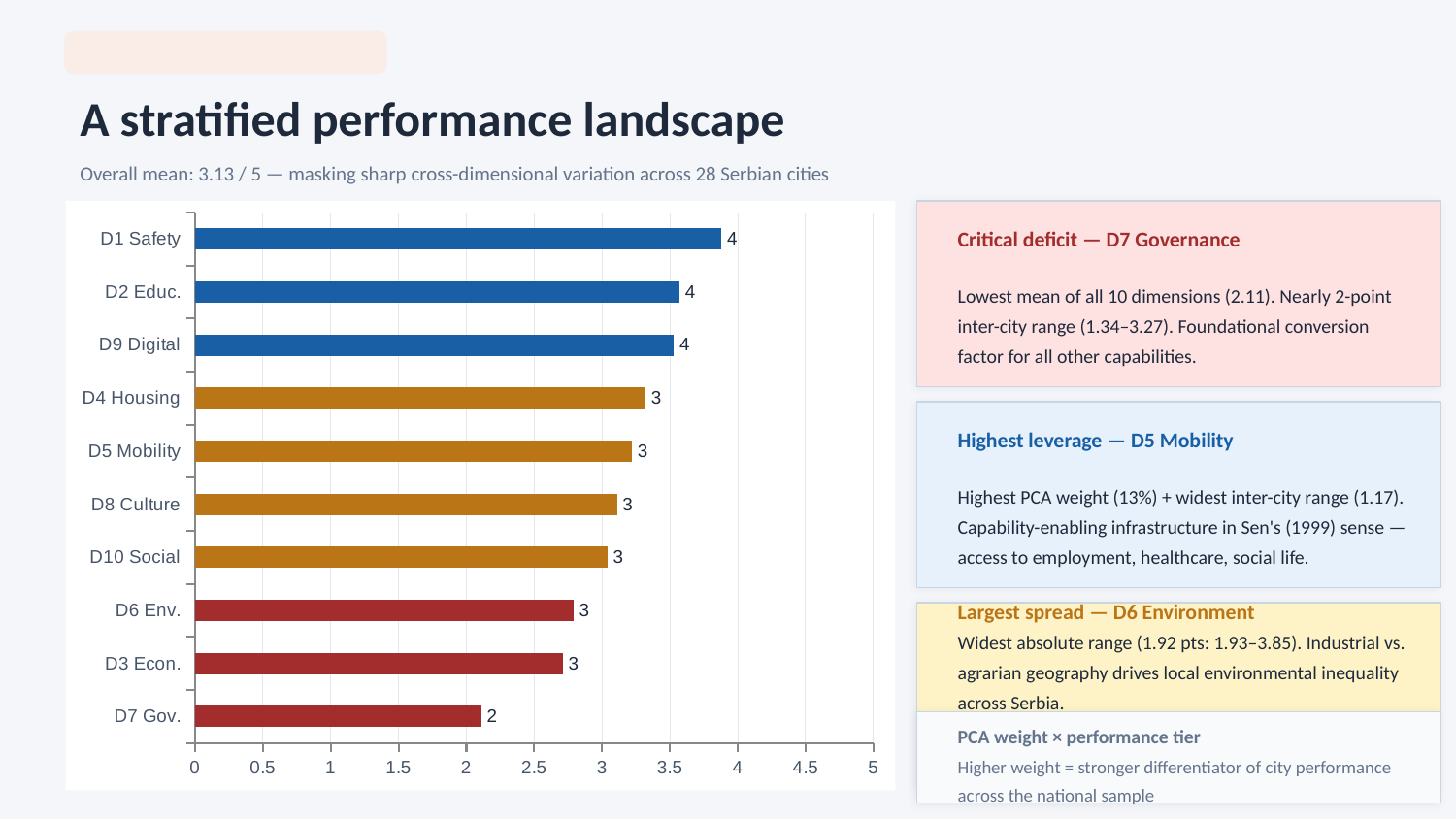
Which dimension has the lowest value in the chart? D7 Gov. Which has a larger value, D4 Housing or D3 Econ.? D4 Housing How many dimensions (bars) are plotted in the chart? 10 What data label is shown next to the bar for D7 Gov.? 2 What type of chart is shown on the slide? bar chart Is the value for D1 Safety greater or less than 3.5? greater Which dimension has the highest value in the chart? D1 Safety How many bars in the chart are coloured red? 3 What data label is shown next to the bar for D5 Mobility? 3 Is the value for D7 Gov. greater or less than 2.5? less What data label is shown next to the bar for D1 Safety? 4